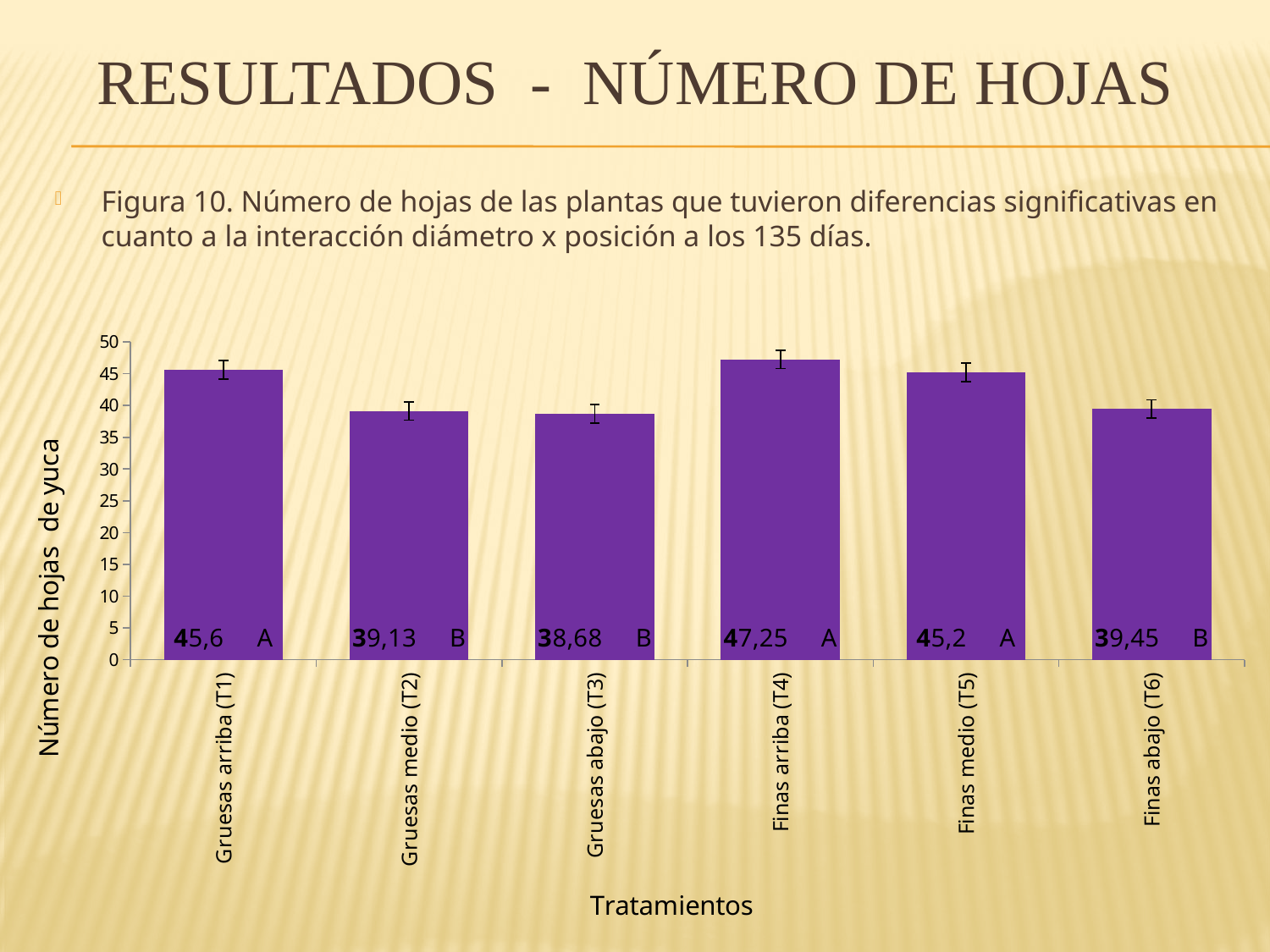
Which is larger, the value for Finas abajo (T6) or Gruesas medio (T2)? Finas abajo (T6) What is the difference between the values for Finas arriba (T4) and Gruesas abajo (T3)? 8,57 How many treatments are shown on the x axis? 6 Which treatment has the highest number of leaves? Finas arriba (T4) Is the value for Gruesas medio (T2) greater or less than 40? less What is the title of the y axis? Número de hojas de yuca What is the value for Gruesas arriba (T1)? 45,6 What kind of chart is shown on the slide? bar chart What is the difference between the values for Gruesas arriba (T1) and Finas medio (T5)? 0,4 What is the value for Gruesas medio (T2)? 39,13 Which treatment has the lowest number of leaves? Gruesas abajo (T3) What is the value for Finas abajo (T6)? 39,45